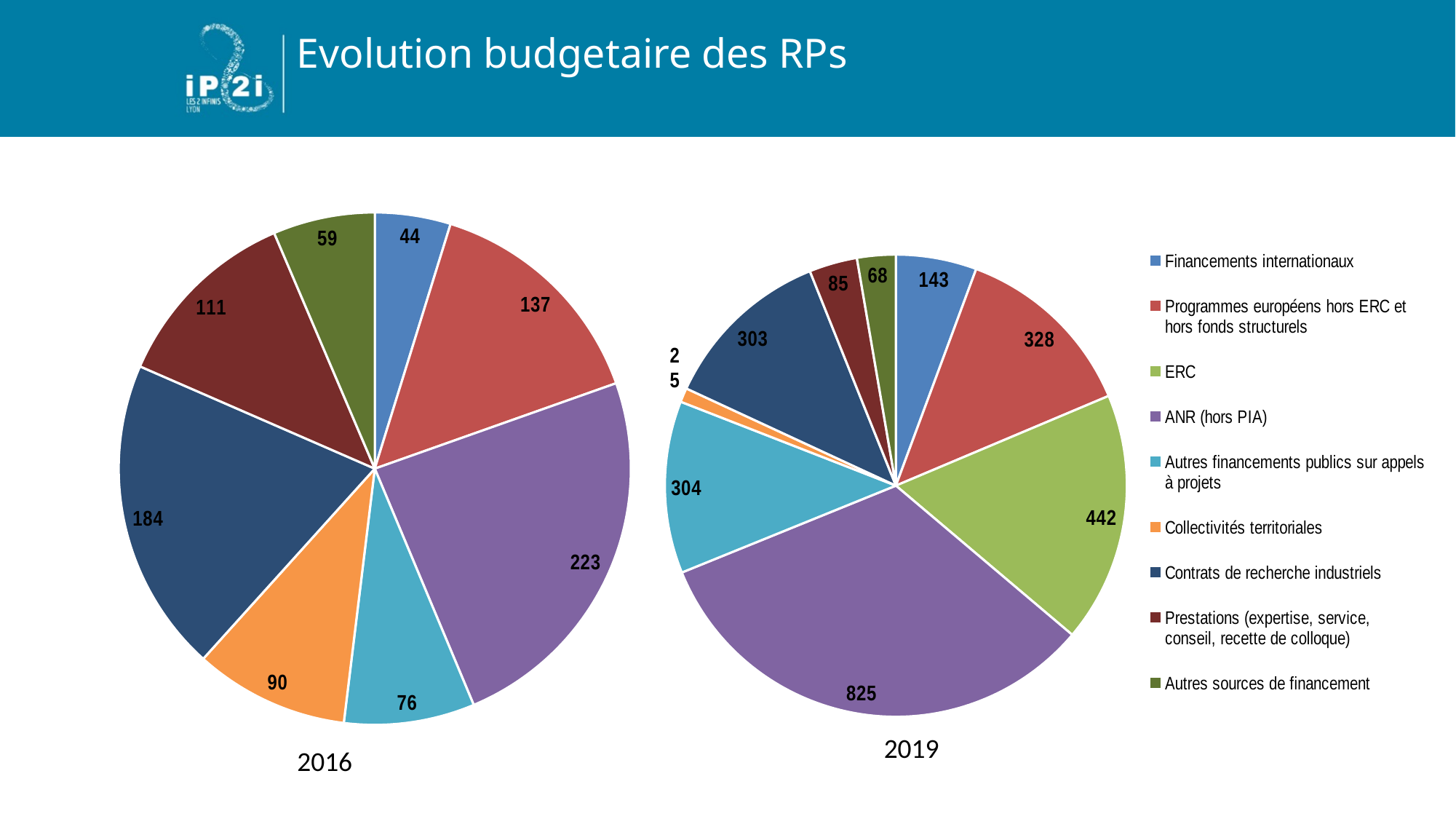
In the 2016 pie chart, which is larger: Contrats de recherche industriels or Programmes européens hors ERC et hors fonds structurels? Contrats de recherche industriels What type of chart is used to show the 2016 and 2019 budgets? Pie chart In the 2019 pie chart, which category has the largest slice? ANR (hors PIA) In the 2019 pie chart, what is the value for Financements internationaux? 143 How many categories does the legend list? 9 In the 2016 pie chart, what is the value for ANR (hors PIA)? 223 How much larger is the ANR (hors PIA) value in the 2019 pie chart than in the 2016 pie chart? 602 In the 2016 pie chart, what is the difference between Contrats de recherche industriels and Collectivités territoriales? 94 In the 2019 pie chart, what is the value for ERC? 442 In the 2016 pie chart, what is the value for Prestations (expertise, service, conseil, recette de colloque)? 111 In the 2016 pie chart, which category has the smallest slice? Financements internationaux How many slices does the 2016 pie chart have? 8